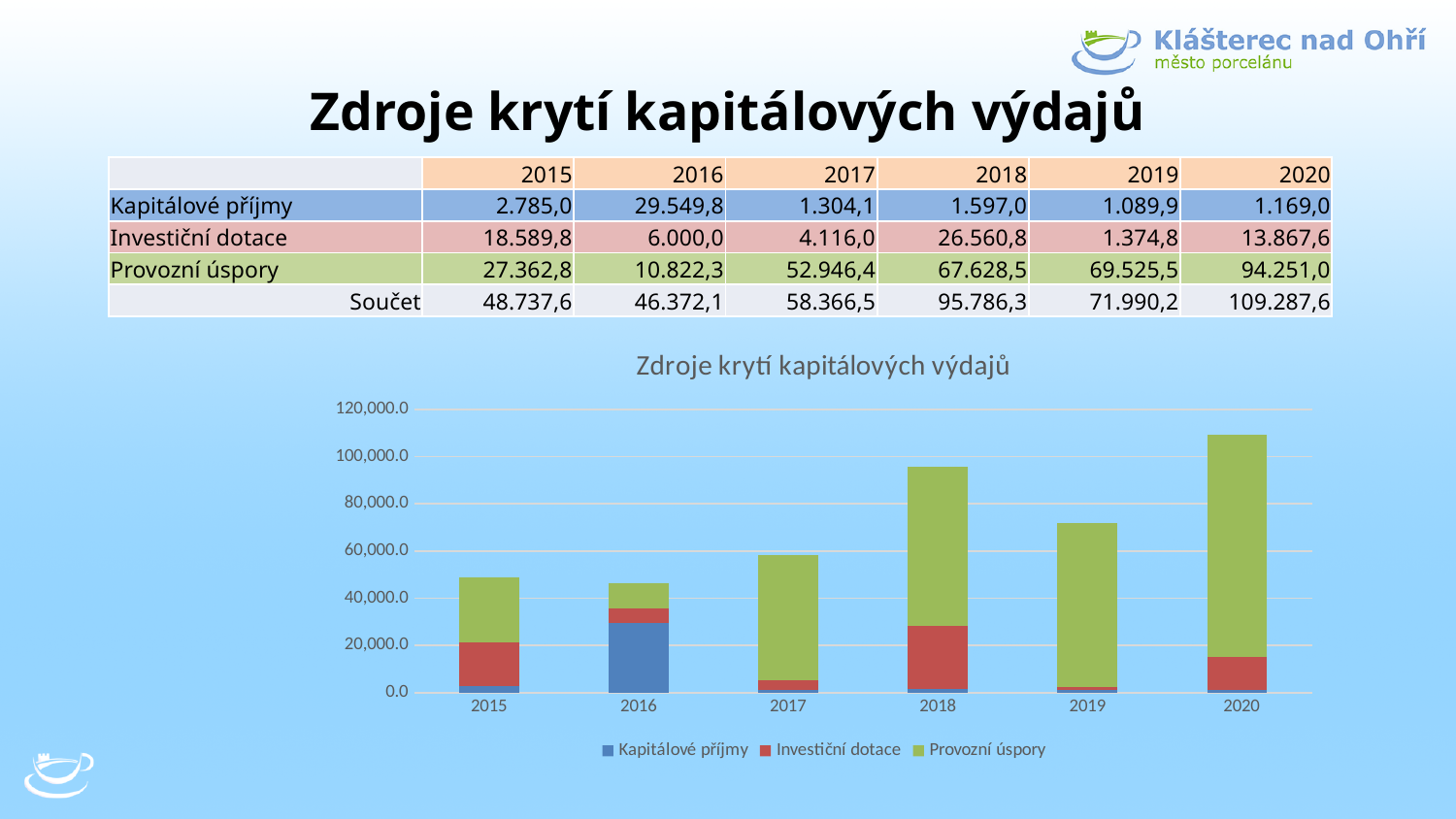
What is the value of Provozní úspory for 2020? 94.251,0 What is the value of Kapitálové příjmy for 2016? 29.549,8 Which year has the shortest stacked bar in the chart? 2016 Which colour represents Provozní úspory in the chart legend? Green How many series does the chart legend list? 3 What is the difference between Investiční dotace in 2018 and in 2019? 25.186,0 Is the total stacked bar for 2019 greater or less than 60,000.0? greater What kind of chart is shown on the slide? Stacked bar chart Which year has the tallest stacked bar in the chart? 2020 How many years are shown on the x axis of the chart? 6 What is the total (Součet) of the stacked bar for 2018? 95.786,3 Which year has the larger Provozní úspory value, 2016 or 2017? 2017